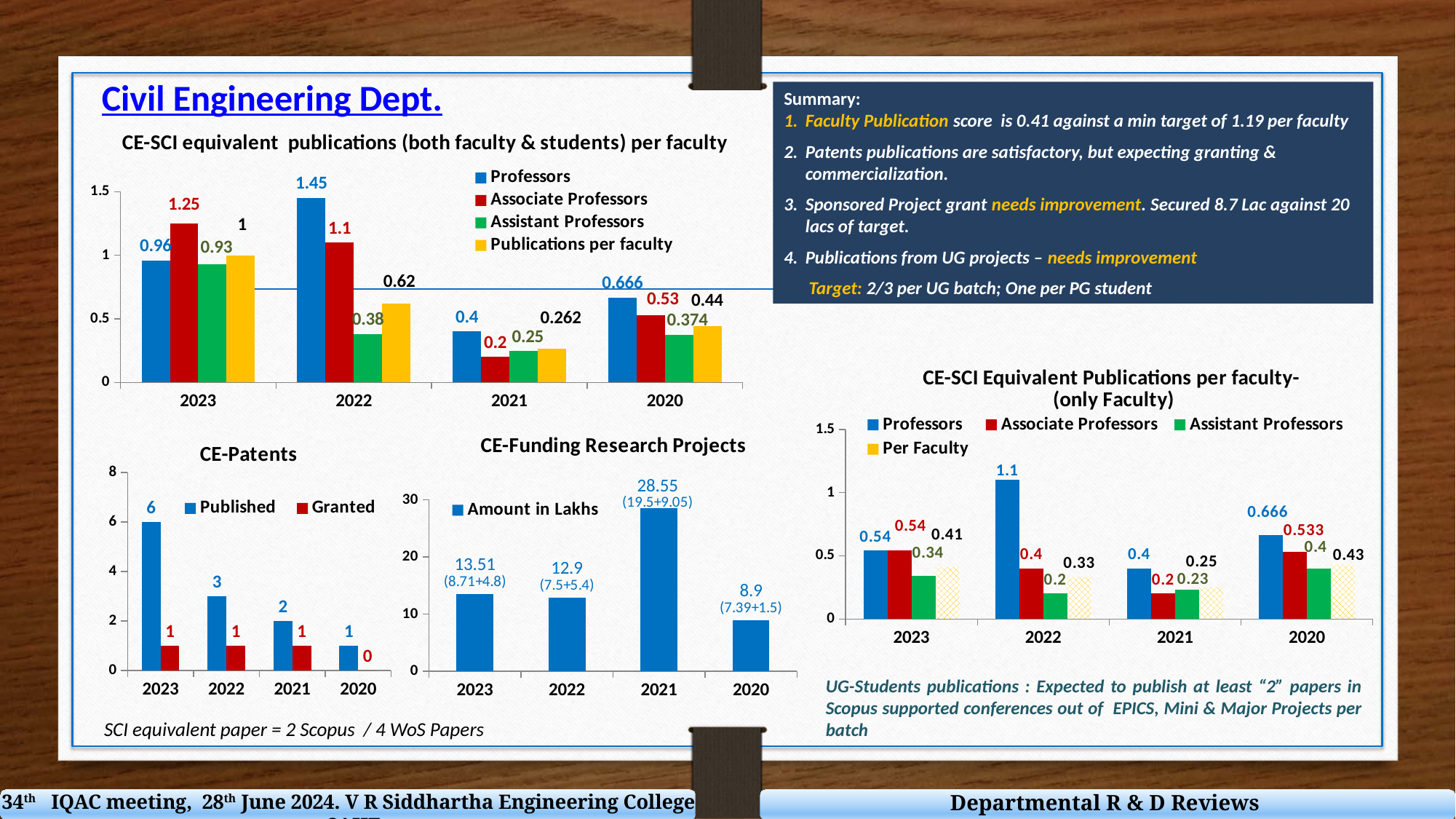
In the 'CE-Patents' chart, how many patents were Published in 2023? 6 In the 'CE-Funding Research Projects' chart, what is the Amount in Lakhs for 2021? 28.55 In the 'CE-SCI equivalent publications (both faculty & students) per faculty' chart, how many series does the legend list? 4 In the 'CE-SCI equivalent publications (both faculty & students) per faculty' chart, what is the value for Professors in 2022? 1.45 In the 'CE-SCI equivalent publications (both faculty & students) per faculty' chart, what is the difference between the Professors value and the Assistant Professors value in 2020? 0.292 In the 'CE-Funding Research Projects' chart, what kind of chart is shown? bar chart In the 'CE-SCI equivalent publications (both faculty & students) per faculty' chart, which year has the highest value for Associate Professors? 2023 In the 'CE-SCI Equivalent Publications per faculty (only Faculty)' chart, which is larger in 2021: Assistant Professors or Associate Professors? Assistant Professors In the 'CE-Patents' chart, do the Published values rise or fall from 2023 to 2020 along the x axis? fall In the 'CE-Patents' chart, which year has the lowest Granted value? 2020 In the 'CE-Funding Research Projects' chart, which year has the lowest Amount in Lakhs? 2020 In the 'CE-SCI Equivalent Publications per faculty (only Faculty)' chart, what is the Per Faculty value for 2022? 0.33